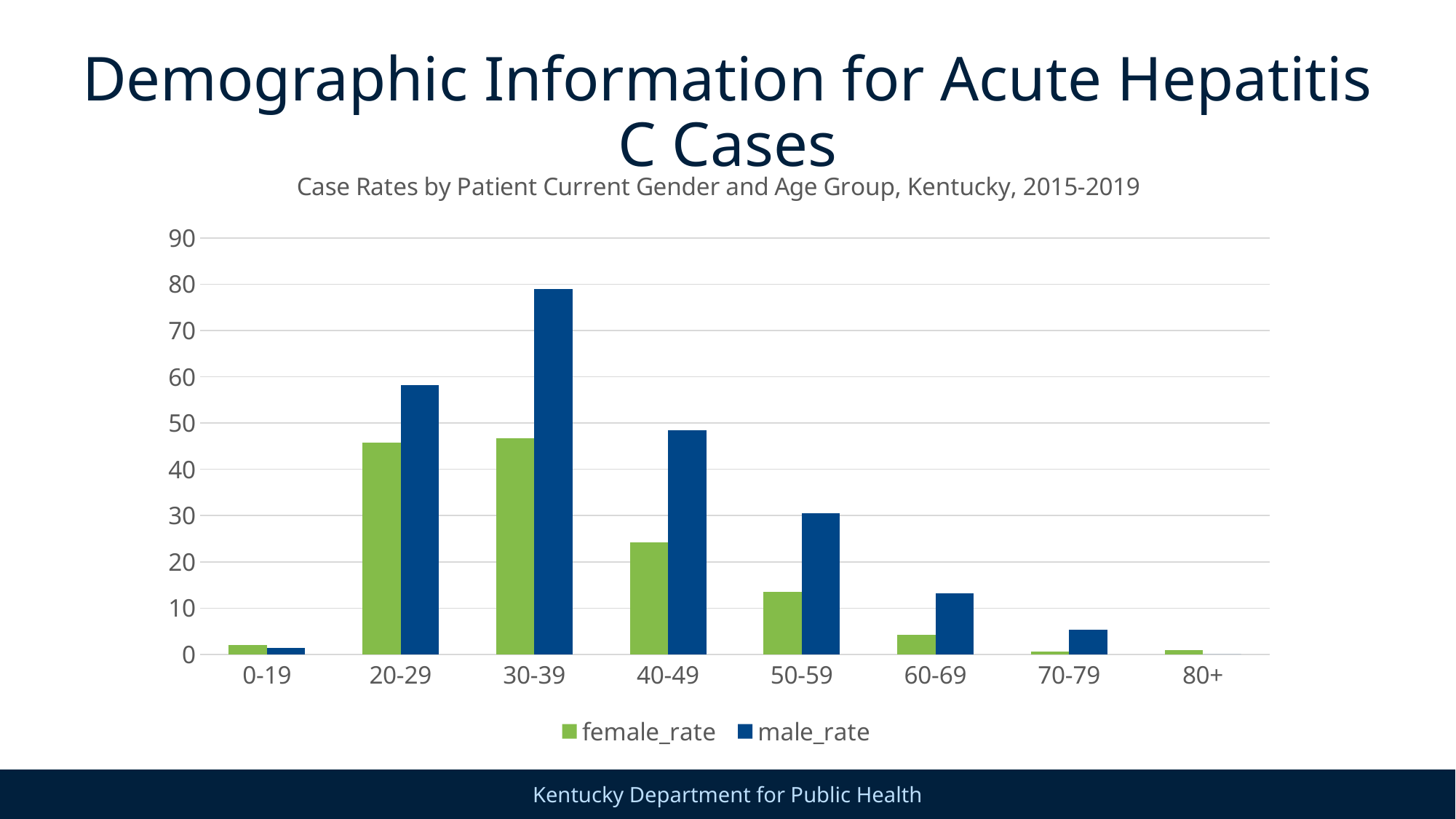
Which is larger for the 40-49 age group, the female_rate or the male_rate? male_rate How many series does the legend list? 2 Which age group has the highest male_rate? 30-39 Is the male_rate for 50-59 greater or less than 20? greater How many age groups are shown on the x axis? 8 Is the male_rate for 30-39 greater or less than 70? greater From the 30-39 age group onward, do the male_rate values rise or fall as age increases? fall What kind of chart is shown on the slide? bar chart Which is larger for the 0-19 age group, the female_rate or the male_rate? female_rate Which age group has the highest female_rate? 30-39 What colour are the female_rate bars? green Is the female_rate for 20-29 greater or less than 50? less